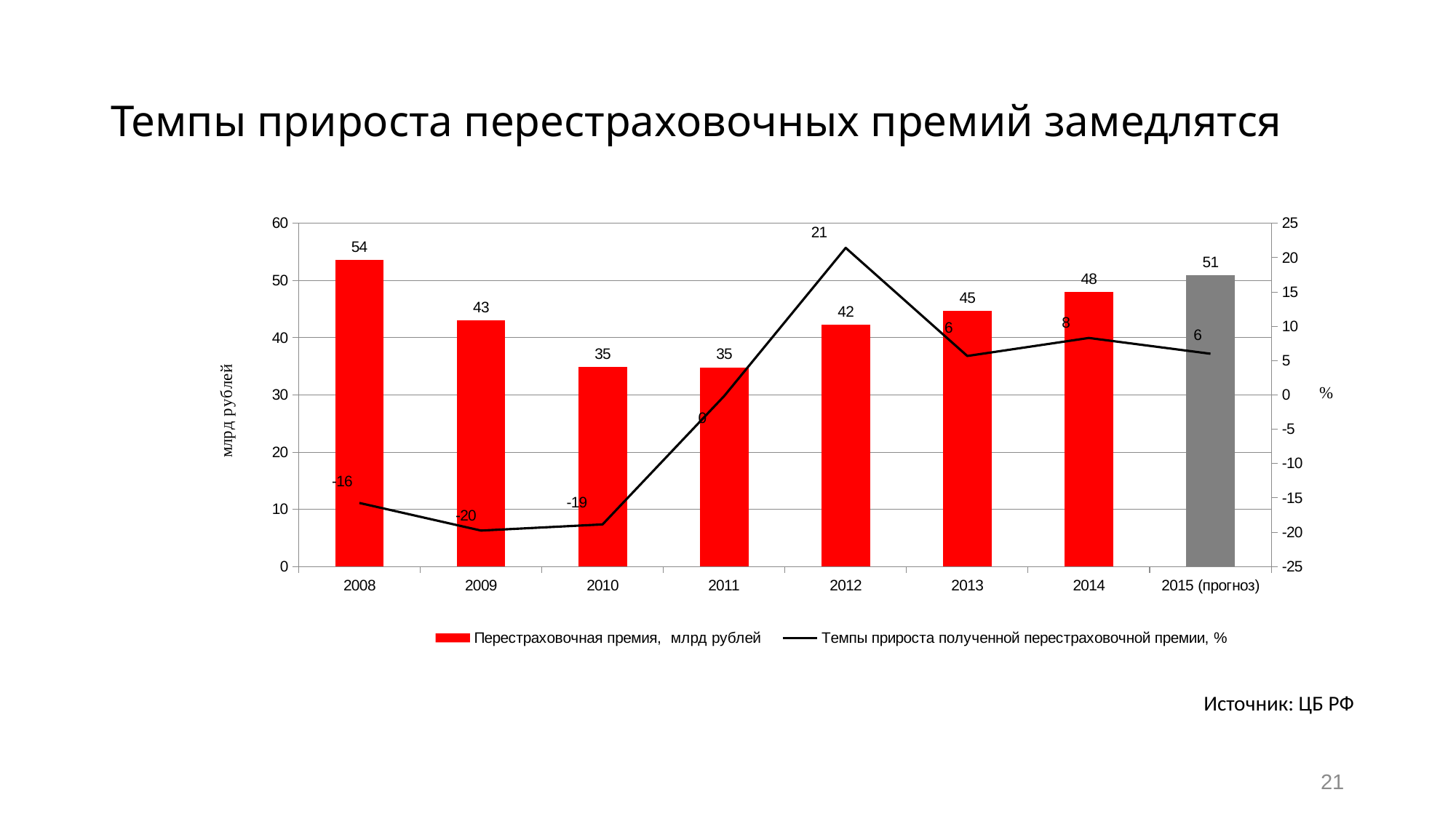
Do the reinsurance premium bars rise or fall from 2011 to 2015 (прогноз)? Rise How many series does the legend list? 2 Which year has the lowest growth rate of reinsurance premium? 2009 What is the reinsurance premium forecast for 2015 (прогноз)? 51 Which year has the highest reinsurance premium? 2008 How many years are shown on the x axis? 8 What is the growth rate (%) for 2009? -20 Which is larger, the reinsurance premium in 2009 or in 2012? 2009 What kind of chart is shown on the slide? Combined bar and line chart What is the growth rate (Темпы прироста, %) for 2012? 21 What is the reinsurance premium (млрд рублей) for 2008? 54 What is the difference between the reinsurance premium in 2014 and in 2013? 3